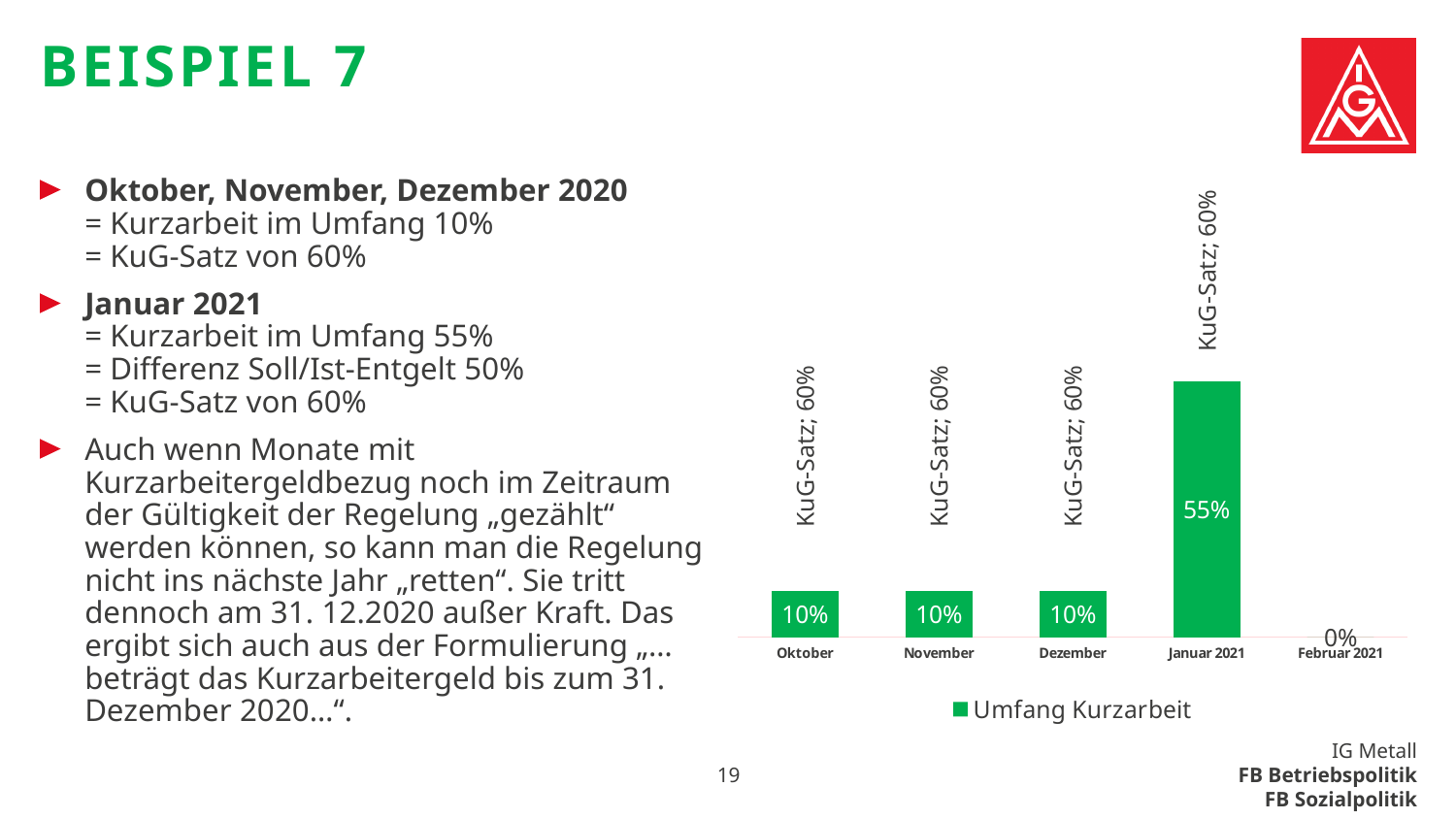
How many series does the chart legend list? 1 What series name is shown in the chart legend? Umfang Kurzarbeit What label is printed above the bar for Januar 2021? KuG-Satz; 60% What kind of chart is shown on the slide? bar chart Which is larger, the value for November or the value for Januar 2021? Januar 2021 What is the value for Januar 2021 in the chart? 55% What is the difference between the values for Januar 2021 and Dezember? 45% How many categories are shown on the x axis of the chart? 5 What is the value for Februar 2021 in the chart? 0% What is the value for Oktober in the chart? 10% Which category has the highest value in the chart? Januar 2021 Which category has the lowest value in the chart? Februar 2021